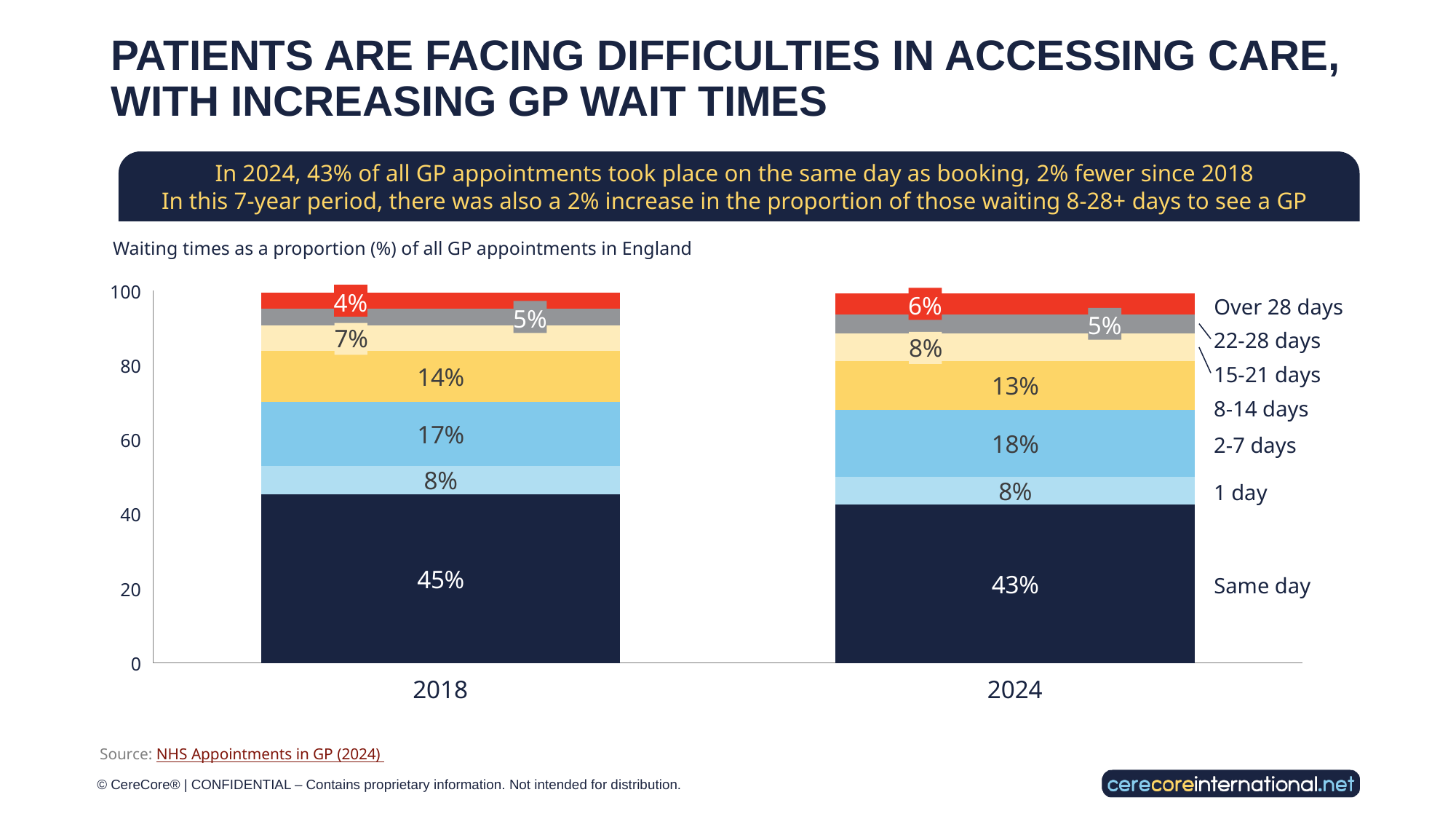
How many waiting-time categories are stacked in each bar? 7 What kind of chart is shown on the slide? Stacked bar chart What is the value for the 2-7 days segment in 2024? 18% What is the value for the 8-14 days segment in 2024? 13% What proportion of GP appointments took place on the same day in 2024? 43% Is the 8-14 days share larger in 2018 or in 2024? 2018 What is the value for the Over 28 days segment in 2018? 4% How many years are shown on the x axis? 2 Which waiting-time category has the smallest share in 2018? Over 28 days What proportion of GP appointments took place on the same day in 2018? 45% Which waiting-time category has the largest share in 2024? Same day By how many percentage points did the Over 28 days share change from 2018 to 2024? 2%